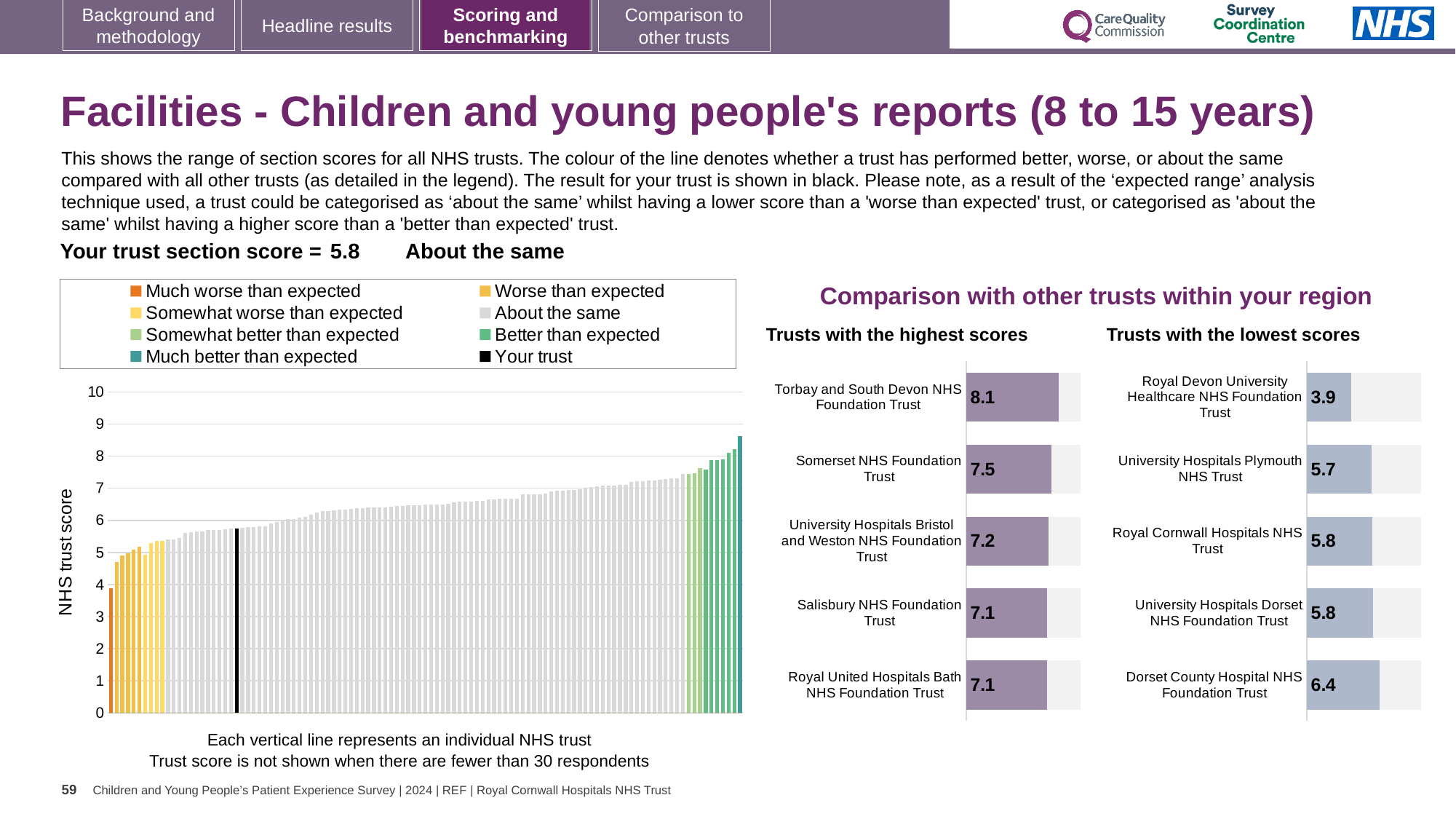
In the large chart on the left, is the value of the tallest bar greater or less than 8? greater In the 'Trusts with the highest scores' chart, what is the score for Somerset NHS Foundation Trust? 7.5 How many trusts are shown in the 'Trusts with the lowest scores' chart? 5 In the 'Trusts with the lowest scores' chart, which trust has the highest score? Dorset County Hospital NHS Foundation Trust In the 'Trusts with the lowest scores' chart, which trust has the lowest score? Royal Devon University Healthcare NHS Foundation Trust In the 'Trusts with the highest scores' chart, what is the difference between the scores of Torbay and South Devon NHS Foundation Trust and Somerset NHS Foundation Trust? 0.6 In the 'Trusts with the lowest scores' chart, what is the score for Royal Devon University Healthcare NHS Foundation Trust? 3.9 In the large chart on the left, do the bar values rise or fall from left to right? rise In the 'Trusts with the highest scores' chart, what is the score for Torbay and South Devon NHS Foundation Trust? 8.1 In the 'Trusts with the highest scores' chart, which has the higher score: Somerset NHS Foundation Trust or University Hospitals Bristol and Weston NHS Foundation Trust? Somerset NHS Foundation Trust How many entries does the legend of the large chart on the left list? 8 In the 'Trusts with the lowest scores' chart, what is the difference between the scores of Dorset County Hospital NHS Foundation Trust and Royal Devon University Healthcare NHS Foundation Trust? 2.5